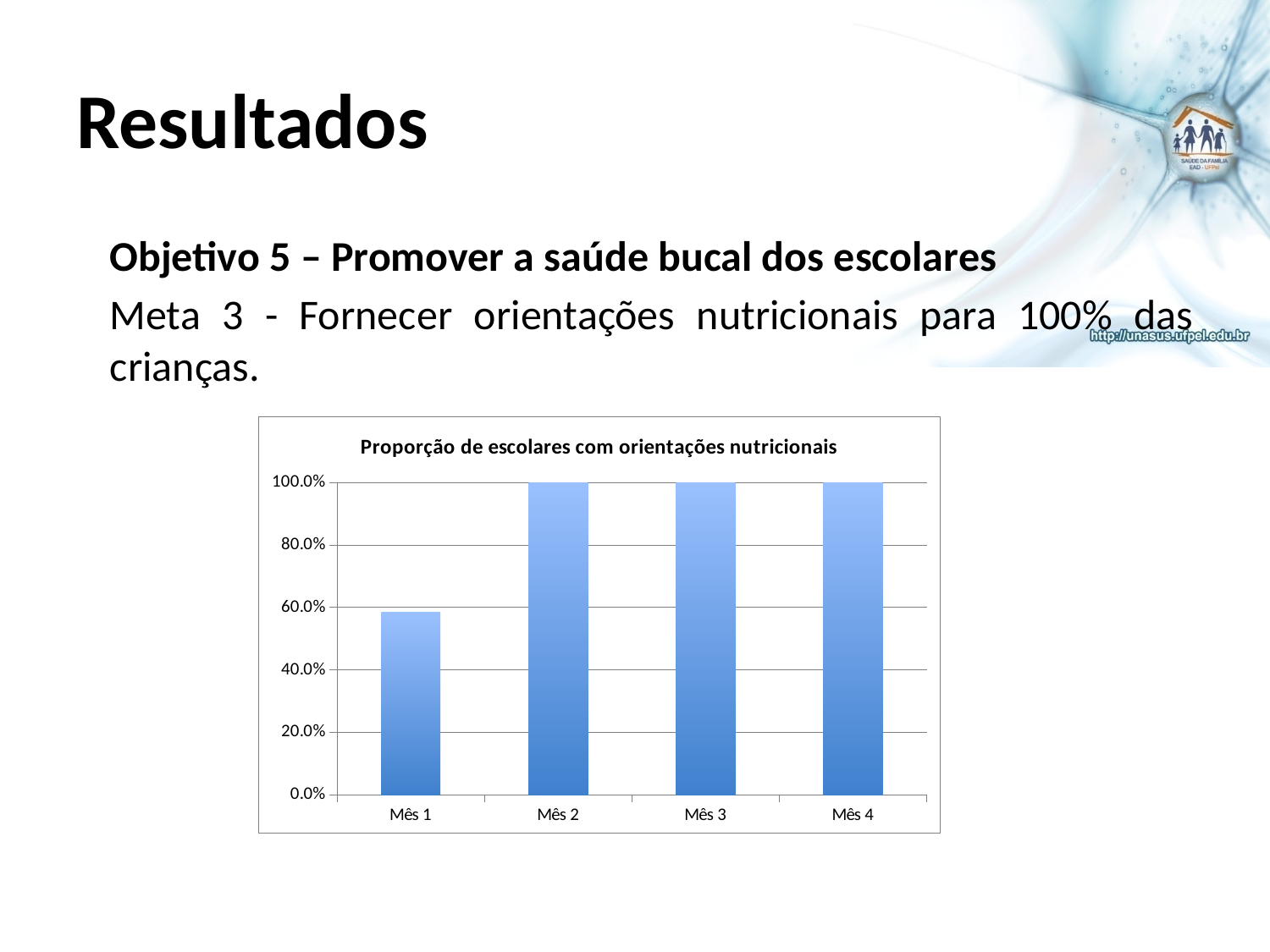
Is the value for Mês 1 greater or less than 80.0%? less What is the highest value shown on the y axis of the chart? 100.0% What kind of chart is shown on the slide? bar chart Does the value rise or fall from Mês 1 to Mês 2? rise How many months reach 100.0% in the chart? 3 Which month has the lowest value in the chart? Mês 1 How many categories (months) are shown on the x axis of the chart? 4 What is the value for Mês 2 in the chart? 100.0% Is the value for Mês 1 greater or less than 40.0%? greater What is the title of the chart? Proporção de escolares com orientações nutricionais Which is larger, the value for Mês 1 or the value for Mês 3? Mês 3 What is the value for Mês 4 in the chart? 100.0%